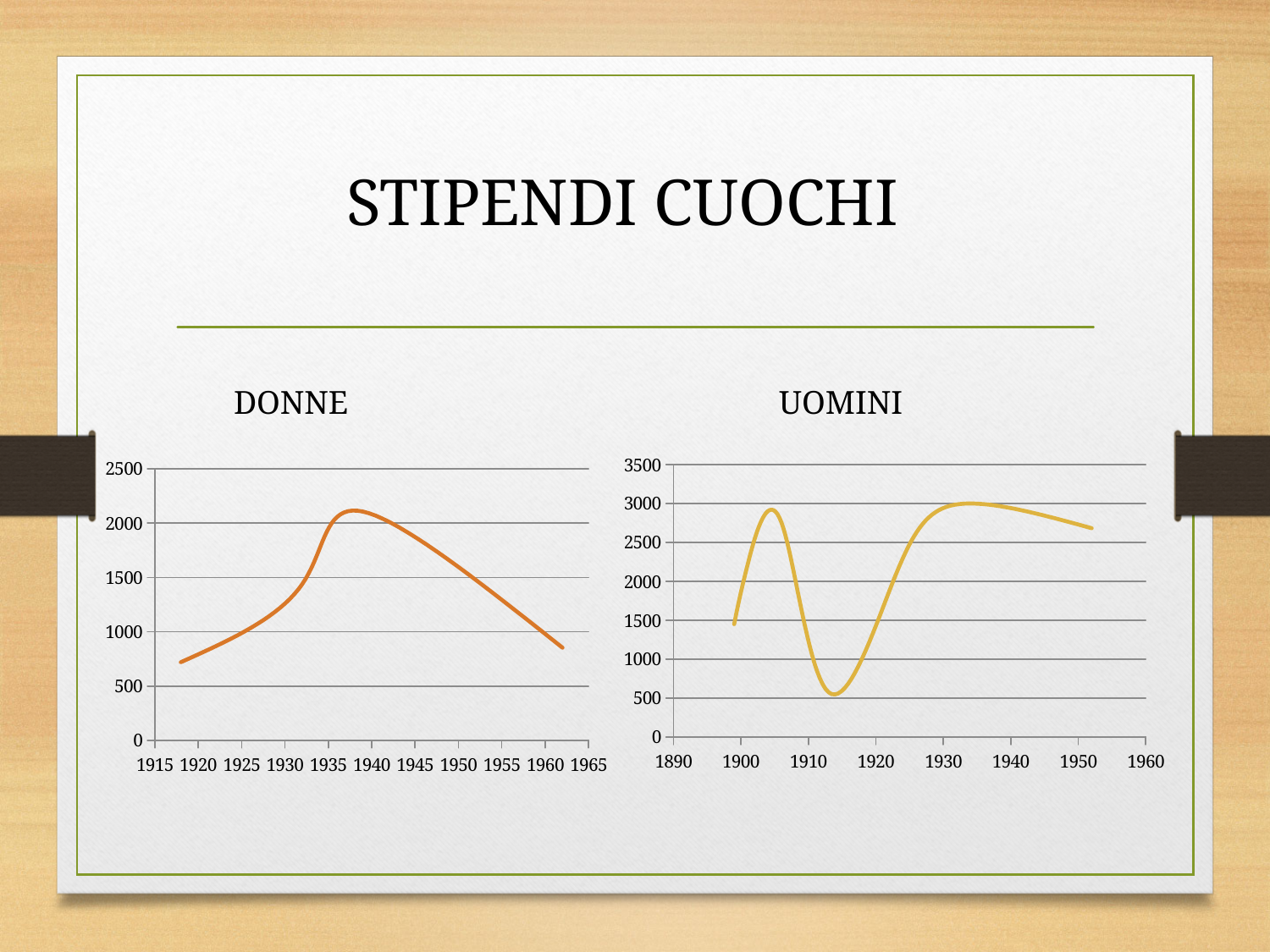
In the DONNE chart, is the value at the end of the line (around 1962) greater or less than 1000? less In the UOMINI chart, is the lowest value of the line (around 1914) greater or less than 1000? less What kind of chart is the DONNE chart? line chart In the DONNE chart, is the value at the start of the line (around 1918) greater or less than 1000? less What kind of chart is the UOMINI chart? line chart In the DONNE chart, does the line rise or fall between 1920 and 1935? rise In the UOMINI chart, does the line rise or fall between 1915 and 1930? rise What is the title of the slide containing the two charts? STIPENDI CUOCHI What is the highest value shown on the vertical axis of the UOMINI chart? 3500 In the DONNE chart, does the line rise or fall between 1940 and 1960? fall